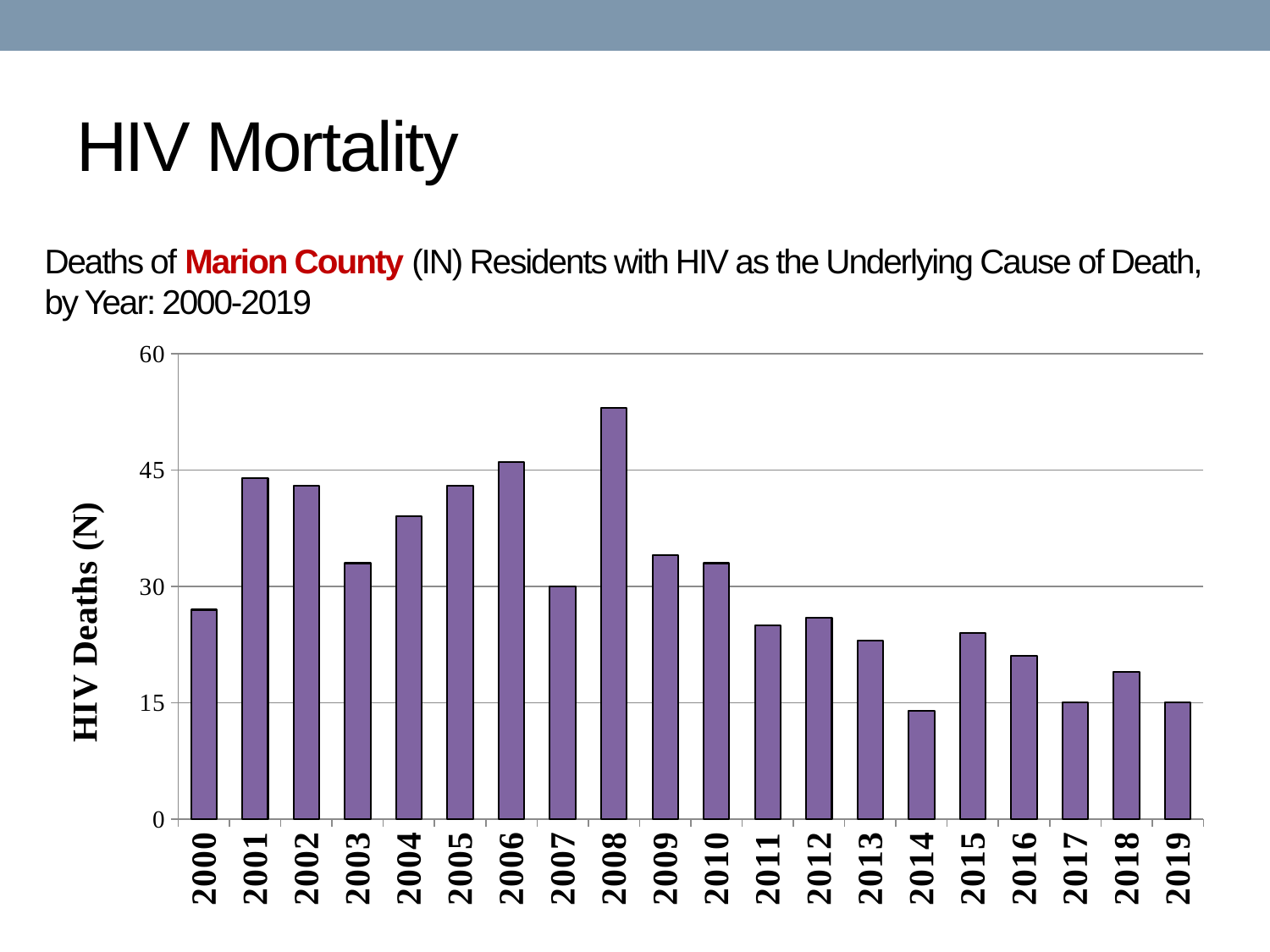
What kind of chart is shown on the slide? bar chart Overall, do HIV deaths rise or fall from 2000 to 2019? fall What is the number of HIV deaths in 2007? 30 Is the value for 2014 greater or less than 15? less How many years are plotted on the chart? 20 Is the value for 2011 greater or less than 30? less Which year has the lowest number of HIV deaths? 2014 Which year has the highest number of HIV deaths? 2008 What is the label on the vertical axis? HIV Deaths (N) Which year has more HIV deaths, 2003 or 2004? 2004 What is the number of HIV deaths in 2019? 15 Is the value for 2006 greater or less than 45? greater